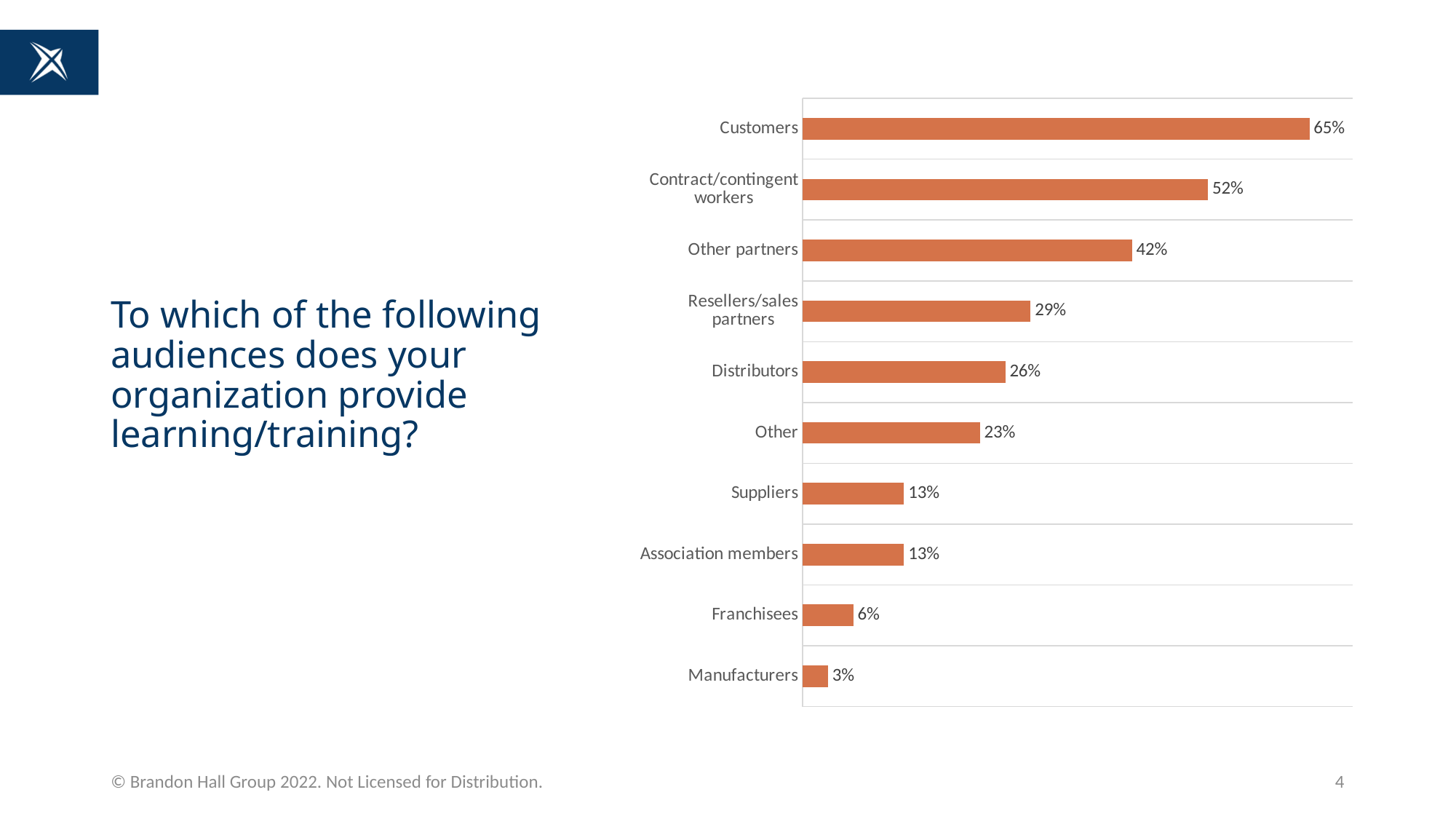
Which audience has the lowest percentage? Manufacturers What is the value shown for Distributors? 26% How many audience categories are shown in the chart? 10 What kind of chart is shown on the slide? Bar chart What is the difference between the values for Customers and Other partners? 23% Which is larger, the value for Other or the value for Suppliers? Other Which audience has the highest percentage? Customers What is the value shown for Contract/contingent workers? 52% What question does the slide title ask? To which of the following audiences does your organization provide learning/training? What percentage of organizations provide learning/training to Customers? 65% What is the value shown for Franchisees? 6% What is the difference between the values for Resellers/sales partners and Distributors? 3%